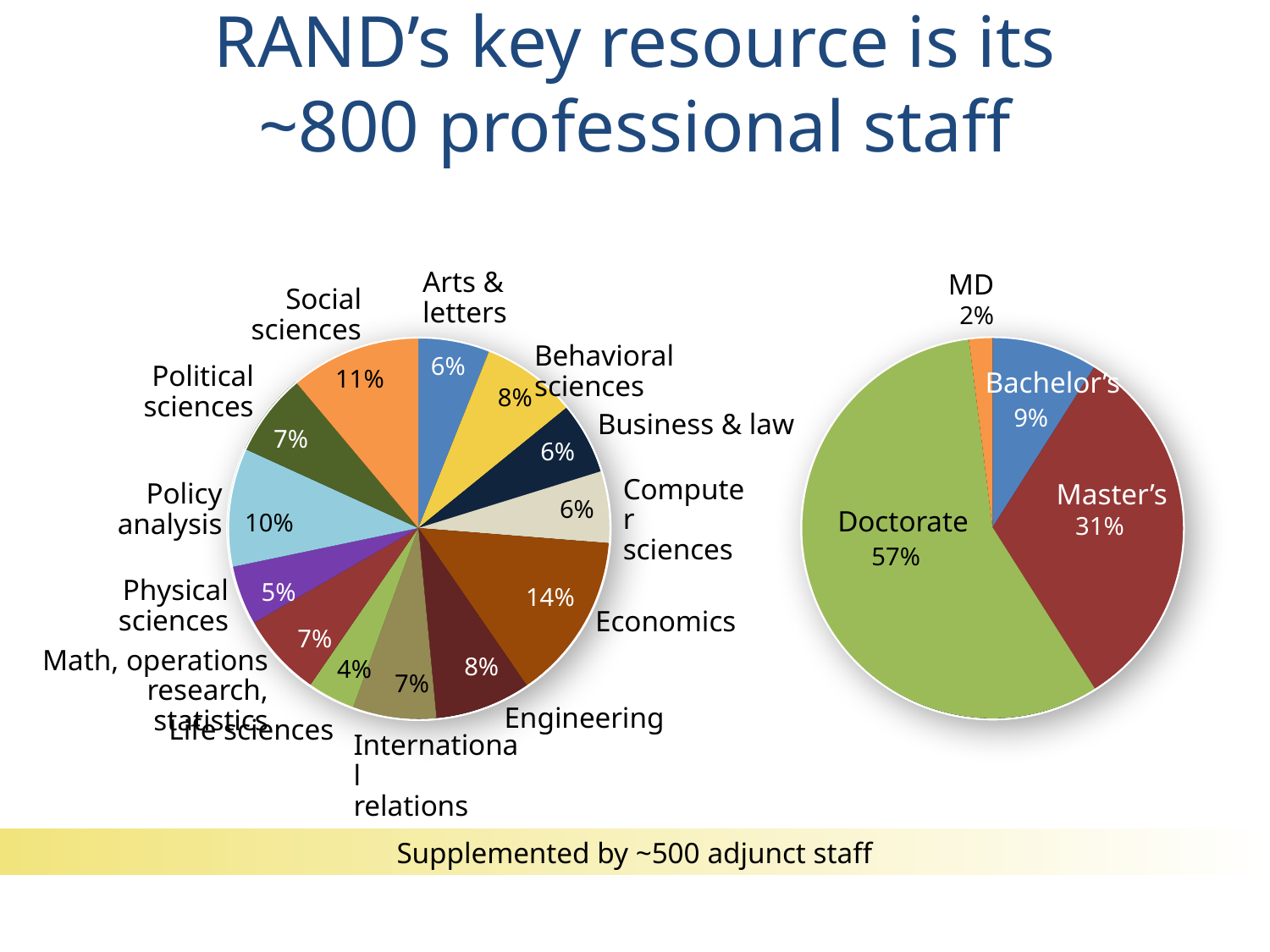
In the left-hand pie chart, which discipline has the largest share? Economics In the left-hand pie chart, which discipline has the smallest share? Life sciences In the left-hand pie chart, how many disciplines are shown? 13 In the right-hand pie chart, what share of staff hold a Master's degree? 31% In the right-hand pie chart, what share of staff hold a Doctorate? 57% In the right-hand pie chart, which degree category has the smallest share? MD In the right-hand pie chart, what is the difference in percentage points between the Doctorate and Master's shares? 26 What type of chart is used on this slide? Pie chart In the right-hand pie chart, how many degree categories are shown? 4 In the left-hand pie chart, which is larger, Social sciences or Political sciences? Social sciences In the left-hand pie chart, what share of staff are in Economics? 14% In the left-hand pie chart, what share of staff are in Policy analysis? 10%